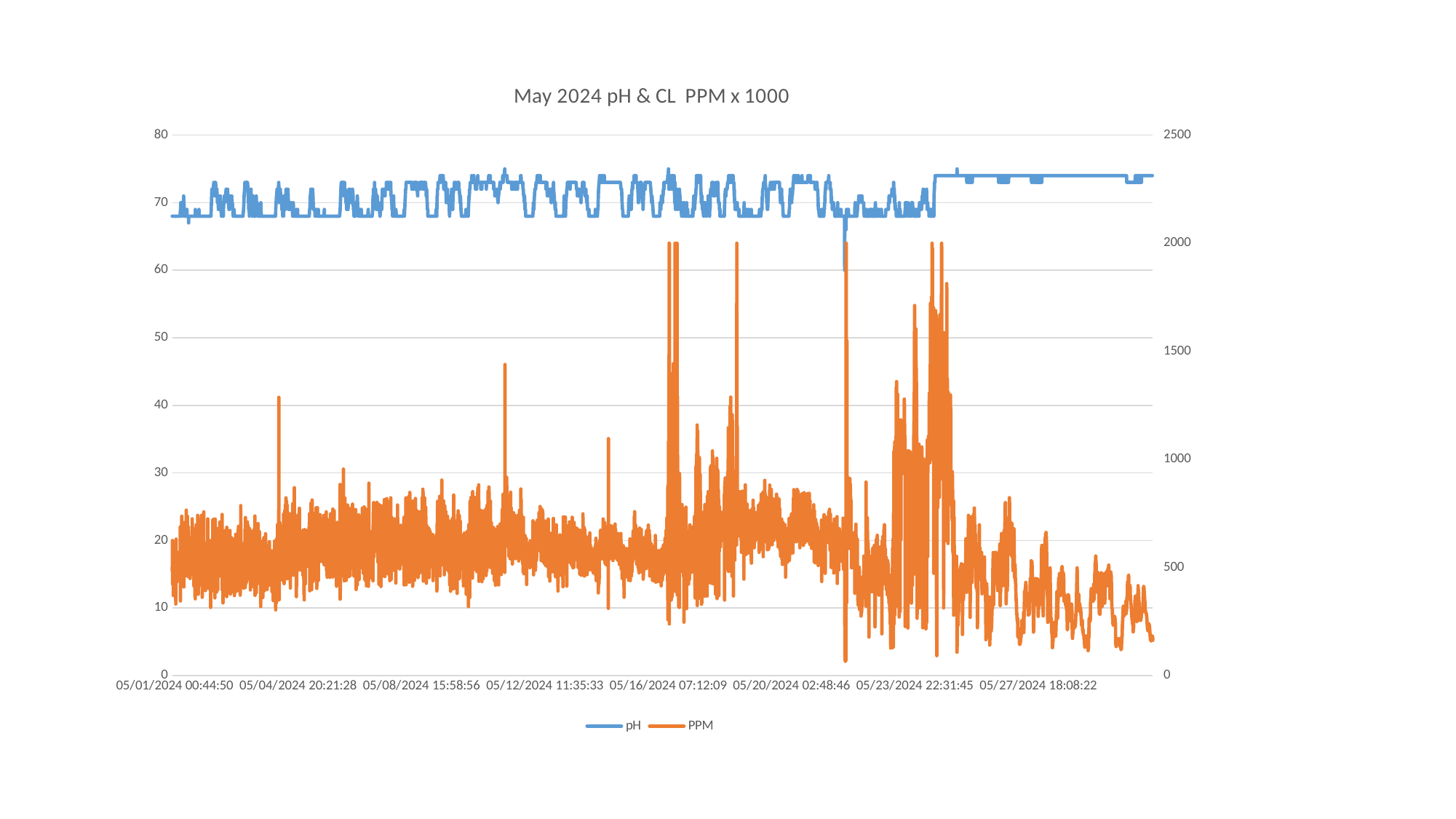
Is the PPM value at the end of the chart greater or less than 500? less How many series does the legend list? 2 Does the PPM line end higher or lower than it starts? lower What is the highest value shown on the right-hand vertical axis? 2500 Is the pH value at the start of the chart greater or less than 60? greater Is the pH value at the end of the chart greater or less than 70? greater What is the title of the chart? May 2024 pH & CL PPM x 1000 Which series is drawn in orange? PPM What kind of chart is shown on the slide? Line chart How many date-time labels are shown on the x axis? 8 What is the first date-time label on the x axis? 05/01/2024 00:44:50 Does the pH line end higher or lower than it starts? higher